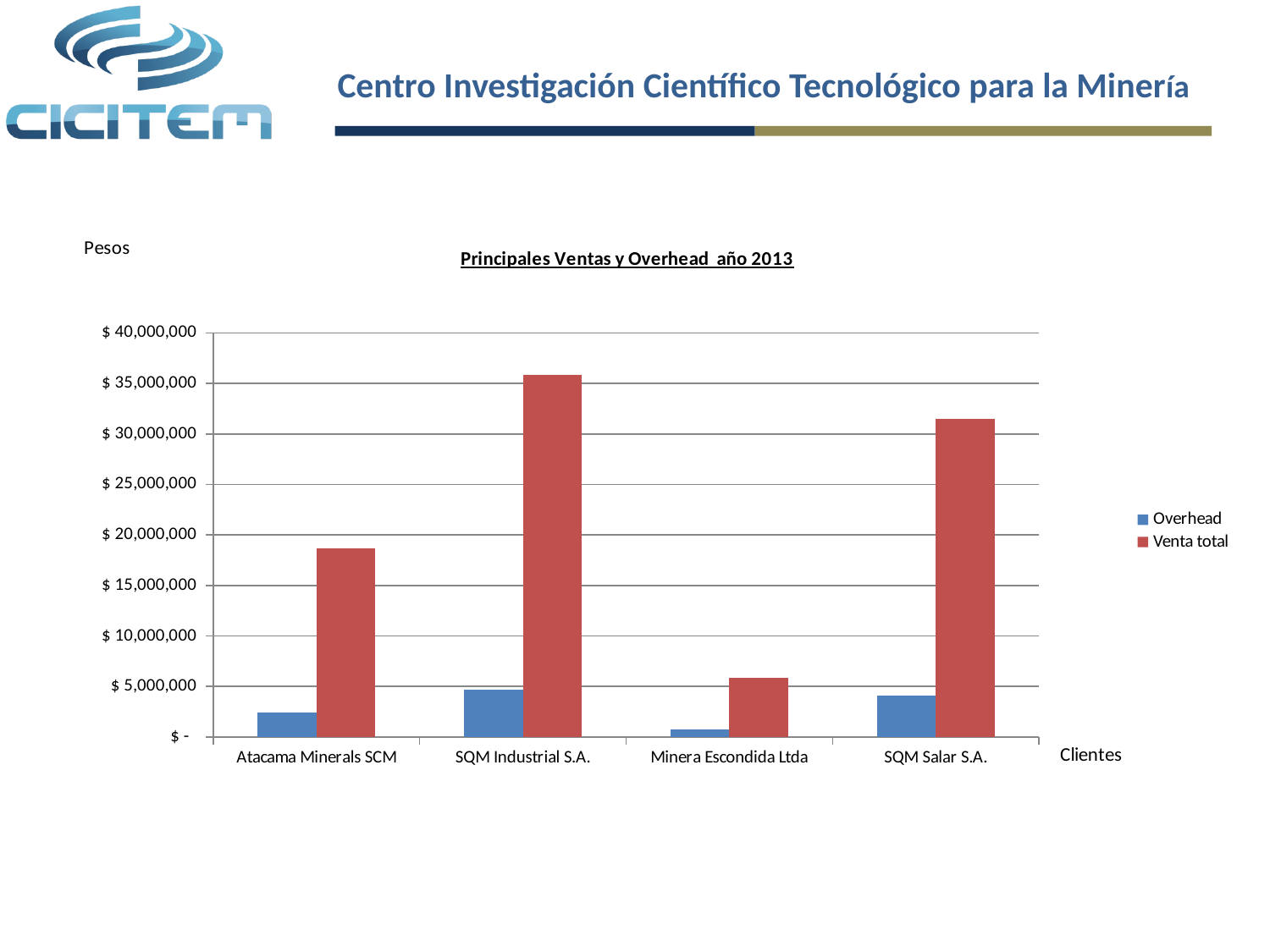
Which client has the highest Venta total? SQM Industrial S.A. Which client has the lowest Overhead? Minera Escondida Ltda Is the Venta total for SQM Salar S.A. greater or less than $ 30,000,000? greater Is the Venta total for Atacama Minerals SCM greater or less than $ 20,000,000? less Is the Venta total for Minera Escondida Ltda greater or less than $ 5,000,000? greater Which is larger, the Venta total for Atacama Minerals SCM or for SQM Salar S.A.? SQM Salar S.A. What is the title of the chart? Principales Ventas y Overhead año 2013 Which client has the lowest Venta total? Minera Escondida Ltda How many clients (categories) are shown on the x axis? 4 What kind of chart is shown on the slide? bar chart How many series does the legend list? 2